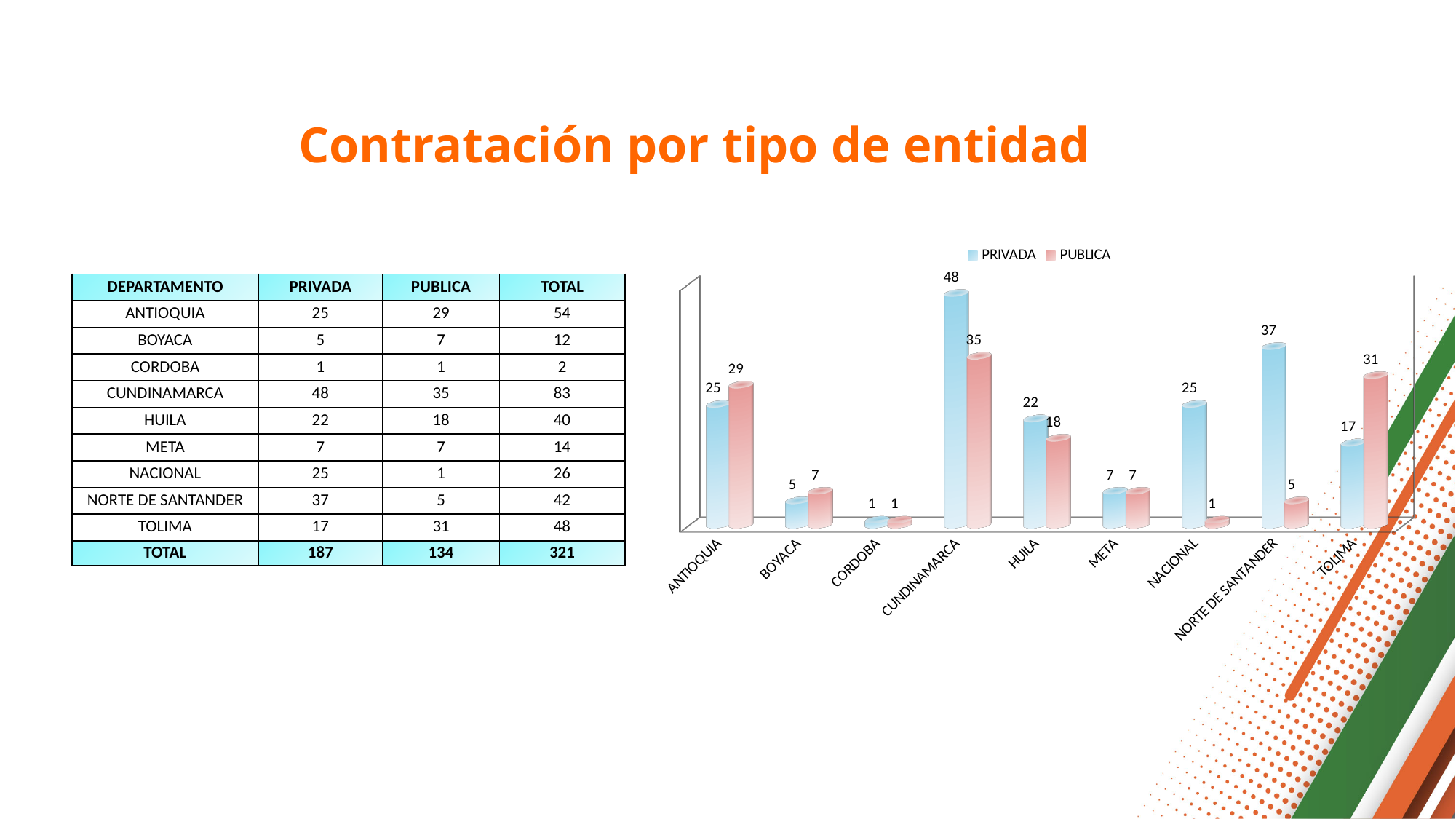
What is the PRIVADA value for CUNDINAMARCA in the chart? 48 How many departments are shown on the x axis of the chart? 9 How many series does the chart legend list? 2 Which department has the highest PUBLICA value in the chart? CUNDINAMARCA What is the PUBLICA value for TOLIMA in the chart? 31 Which department has the lowest PRIVADA value in the chart? CORDOBA What is the PUBLICA value for NACIONAL in the chart? 1 What is the difference between the PRIVADA and PUBLICA values for NORTE DE SANTANDER? 32 Which series is shown in pink in the chart? PUBLICA For ANTIOQUIA, which is larger, the PRIVADA or the PUBLICA value? PUBLICA What kind of chart is shown on the slide? Bar chart Which department has the highest PRIVADA value in the chart? CUNDINAMARCA